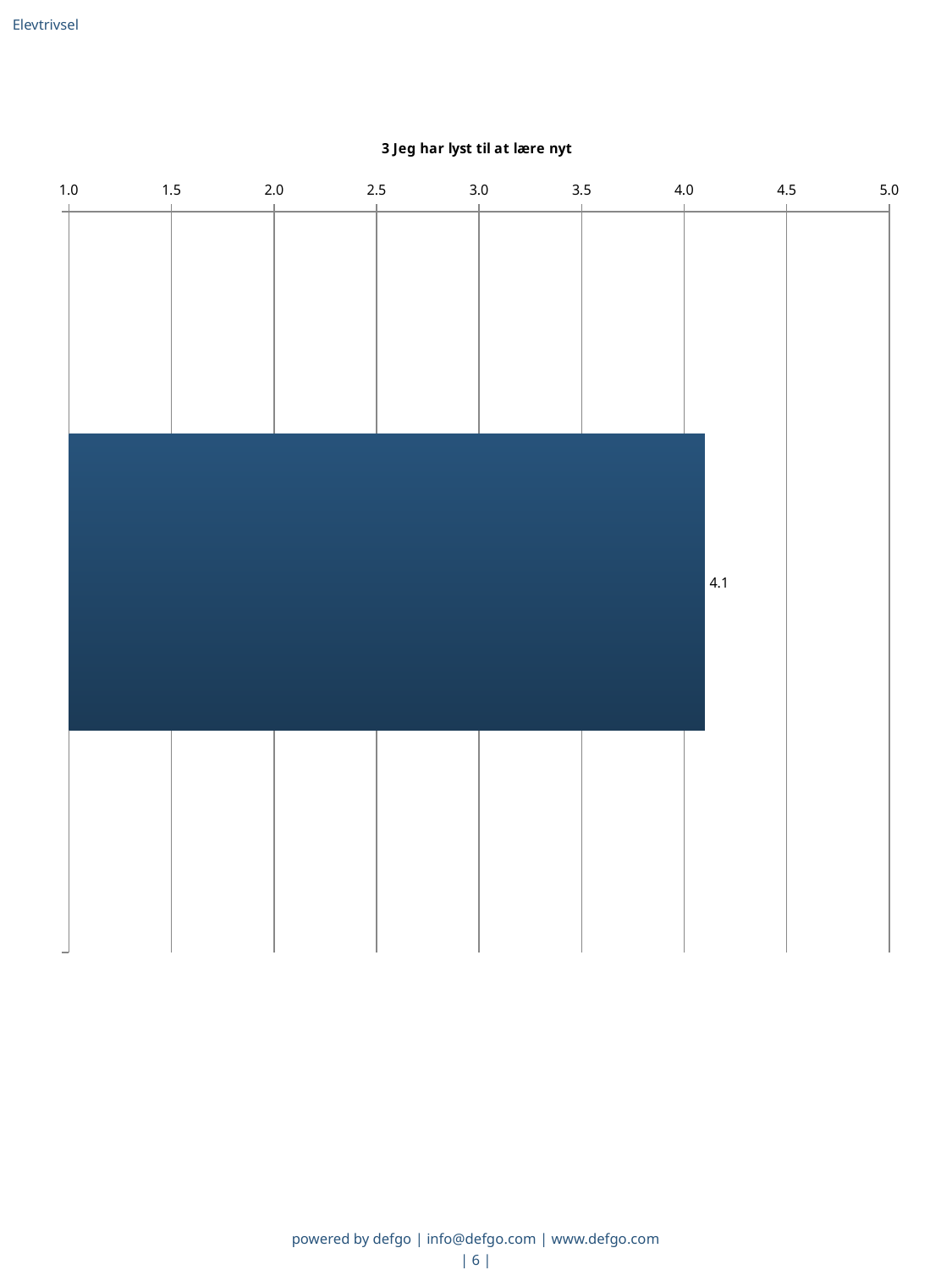
What is the value shown on the bar in the chart? 4.1 What is the maximum value shown on the chart's axis? 5.0 What is the title of the chart? 3 Jeg har lyst til at lære nyt Is the value of the bar greater or less than 4.5? less What kind of chart is shown on the slide? bar chart How many bars are plotted in the chart? 1 Is the value of the bar greater or less than 4.0? greater